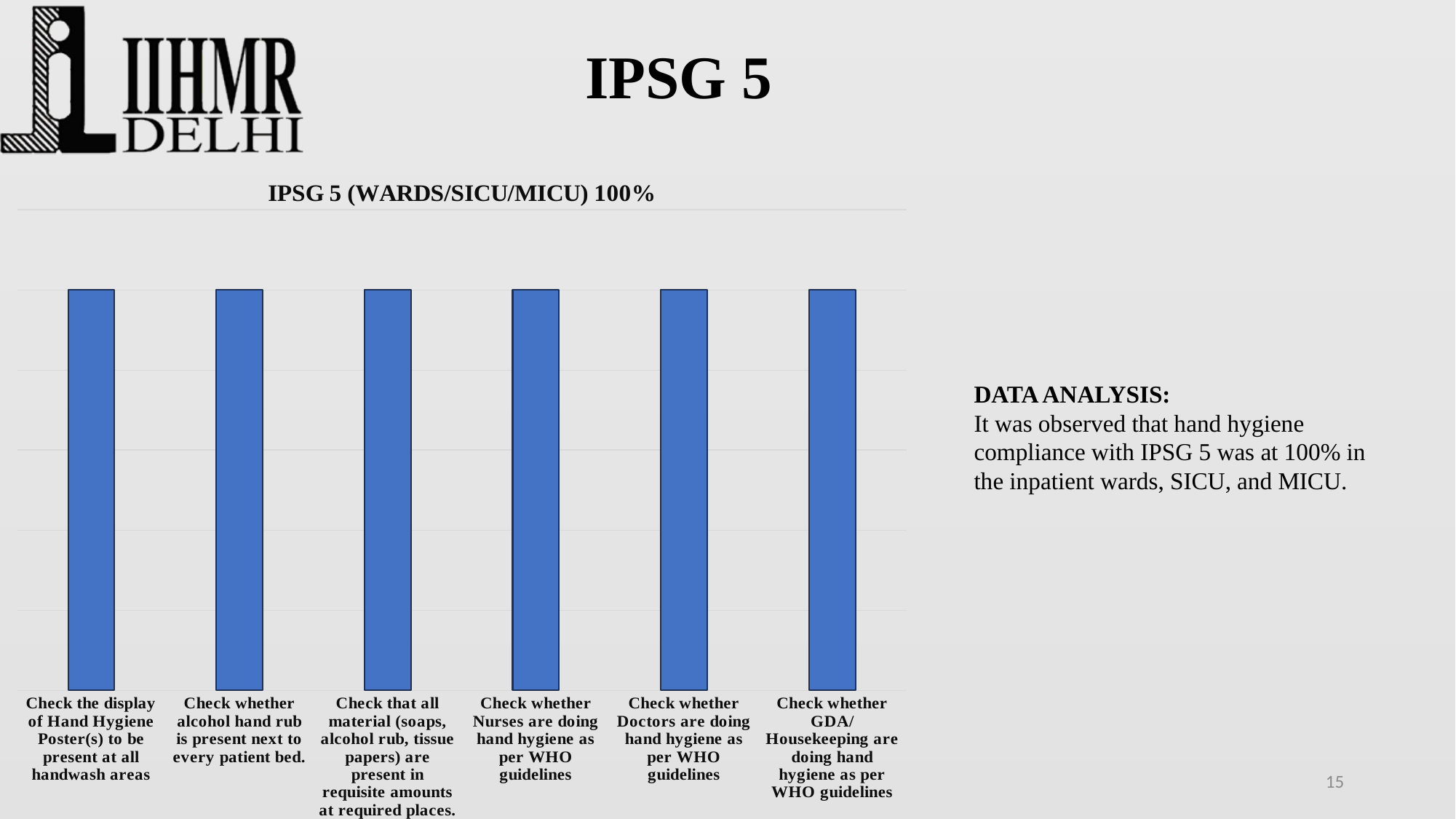
What kind of chart is shown on the slide? Bar chart How many bars (categories) does the chart show? 6 What is the title of the chart? IPSG 5 (WARDS/SICU/MICU) 100% Which category label is the first (leftmost) bar in the chart? Check the display of Hand Hygiene Poster(s) to be present at all handwash areas What colour are the bars in the chart? Blue Do the bar heights rise, fall, or stay the same across the categories from left to right? Stay the same